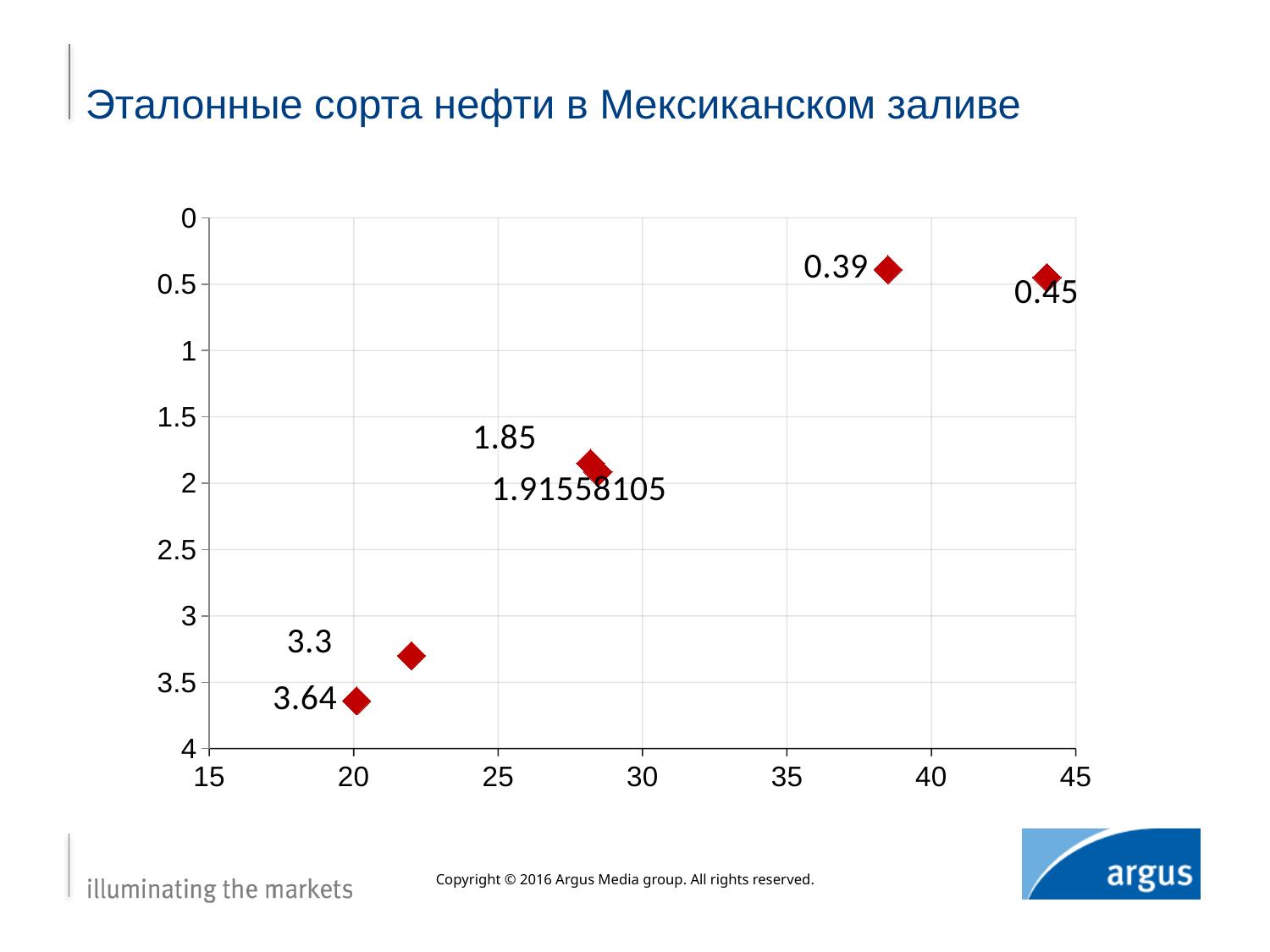
Is the x-axis position of the point labelled 3.64 greater or less than 25? less Which data label is larger, 1.85 or 1.91558105? 1.91558105 Is the x-axis position of the point labelled 0.39 greater or less than 35? greater What is the title of the slide containing the chart? Эталонные сорта нефти в Мексиканском заливе What is the difference between the data labels 0.45 and 0.39? 0.06 What is the difference between the data labels 3.64 and 3.3? 0.34 What is the largest data label value shown on the chart? 3.64 What is the highest value shown on the x axis of the chart? 45 What kind of chart is shown on the slide? scatter chart How many data points are plotted on the chart? 6 What is the smallest data label value shown on the chart? 0.39 As the x-axis values increase, do the labelled data values rise or fall? fall